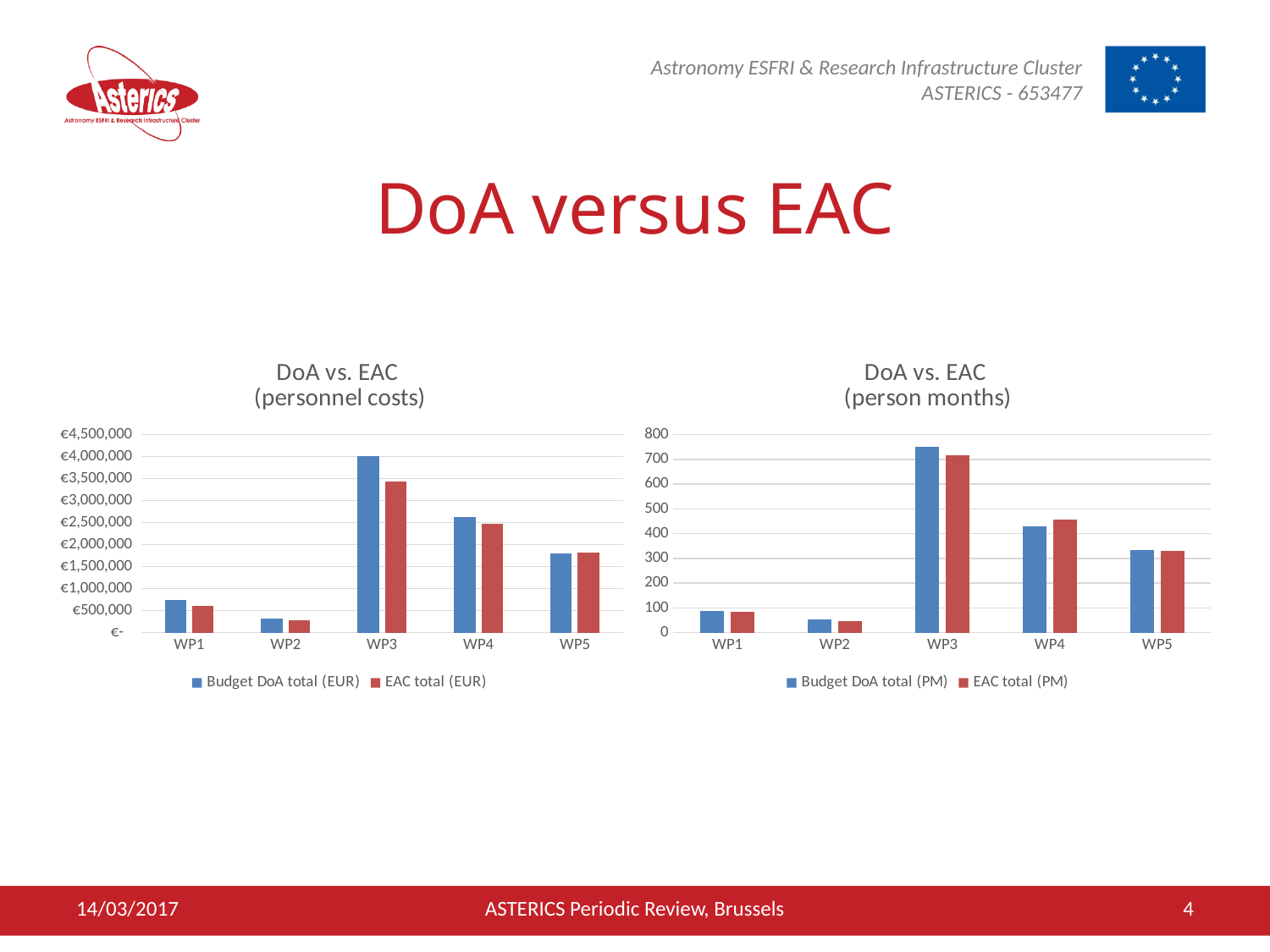
How many series does the legend of the 'DoA vs. EAC (personnel costs)' chart list? 2 In the 'DoA vs. EAC (personnel costs)' chart, which work package has the highest Budget DoA total (EUR)? WP3 In the 'DoA vs. EAC (personnel costs)' chart, is the EAC total (EUR) for WP3 greater or less than €4,000,000? less In the 'DoA vs. EAC (personnel costs)' chart, is the Budget DoA total (EUR) for WP3 greater or less than €3,500,000? greater In the 'DoA vs. EAC (personnel costs)' chart, for WP3, which is larger: Budget DoA total (EUR) or EAC total (EUR)? Budget DoA total (EUR) In the 'DoA vs. EAC (person months)' chart, which work package has the highest EAC total (PM)? WP3 How many work packages are shown on the x axis of the 'DoA vs. EAC (person months)' chart? 5 In the 'DoA vs. EAC (person months)' chart, for WP4, which is larger: Budget DoA total (PM) or EAC total (PM)? EAC total (PM) In the 'DoA vs. EAC (personnel costs)' chart, which work package has the lowest EAC total (EUR)? WP2 What kind of chart is the 'DoA vs. EAC (personnel costs)' chart on the left? bar chart In the 'DoA vs. EAC (personnel costs)' chart, is the Budget DoA total (EUR) for WP1 greater or less than €1,000,000? less